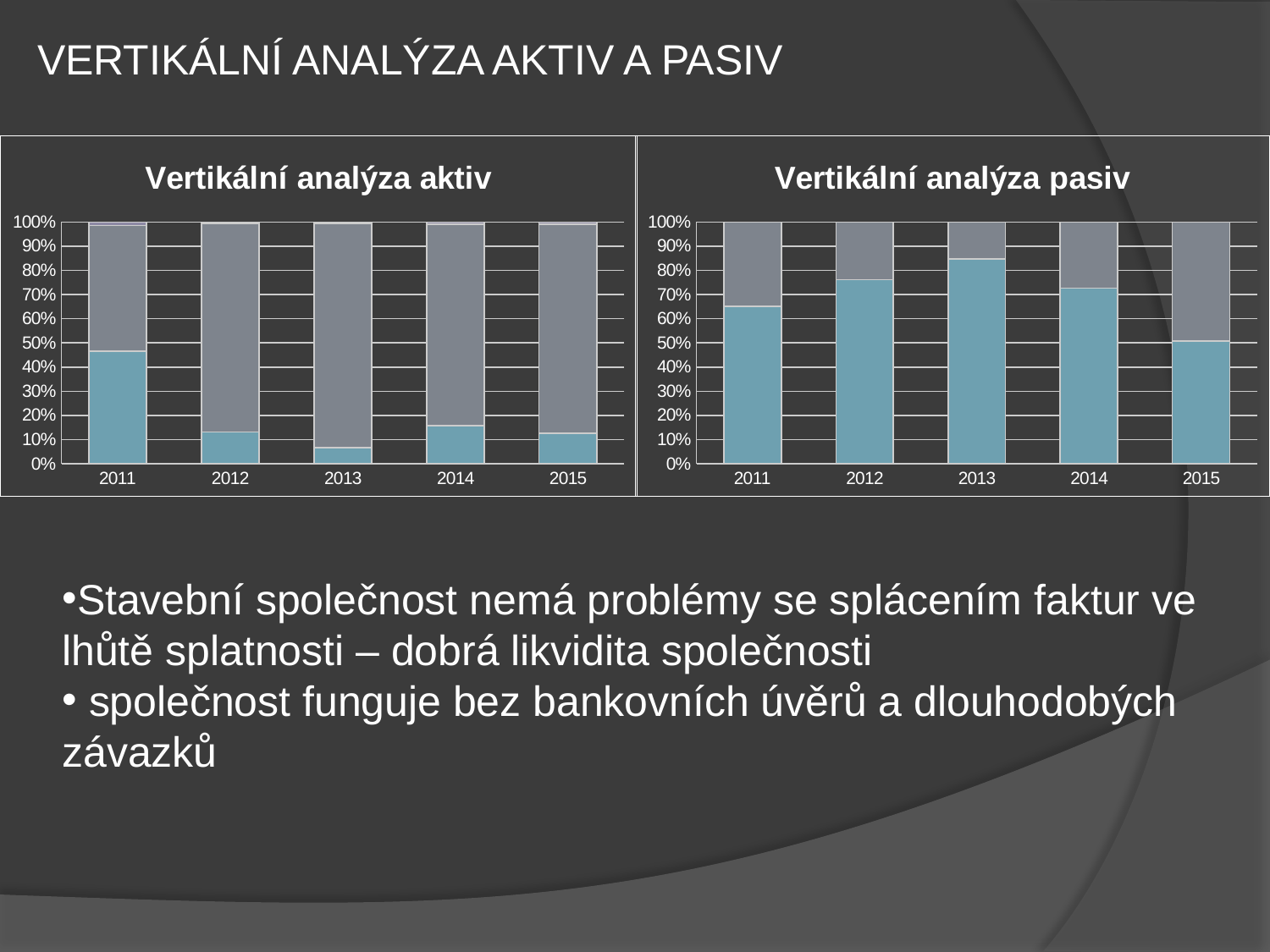
What kind of chart is the "Vertikální analýza aktiv" chart on the left? stacked bar chart In the "Vertikální analýza aktiv" chart, which year has the smallest bottom (blue) segment? 2013 In the "Vertikální analýza pasiv" chart, which year has the smallest bottom (blue) segment? 2015 In the "Vertikální analýza aktiv" chart, is the bottom (blue) segment for 2011 greater or less than 40%? greater How many years are shown on the x axis of the "Vertikální analýza pasiv" chart? 5 In the "Vertikální analýza aktiv" chart, is the bottom (blue) segment for 2013 greater or less than 10%? less In the "Vertikální analýza pasiv" chart, which year has the largest bottom (blue) segment? 2013 In the "Vertikální analýza pasiv" chart, is the bottom (blue) segment larger in 2011 or in 2013? 2013 In the "Vertikální analýza aktiv" chart, which year has the largest bottom (blue) segment? 2011 In the "Vertikální analýza pasiv" chart, is the bottom (blue) segment for 2012 greater or less than 70%? greater What is the title of the chart on the right side of the slide? Vertikální analýza pasiv